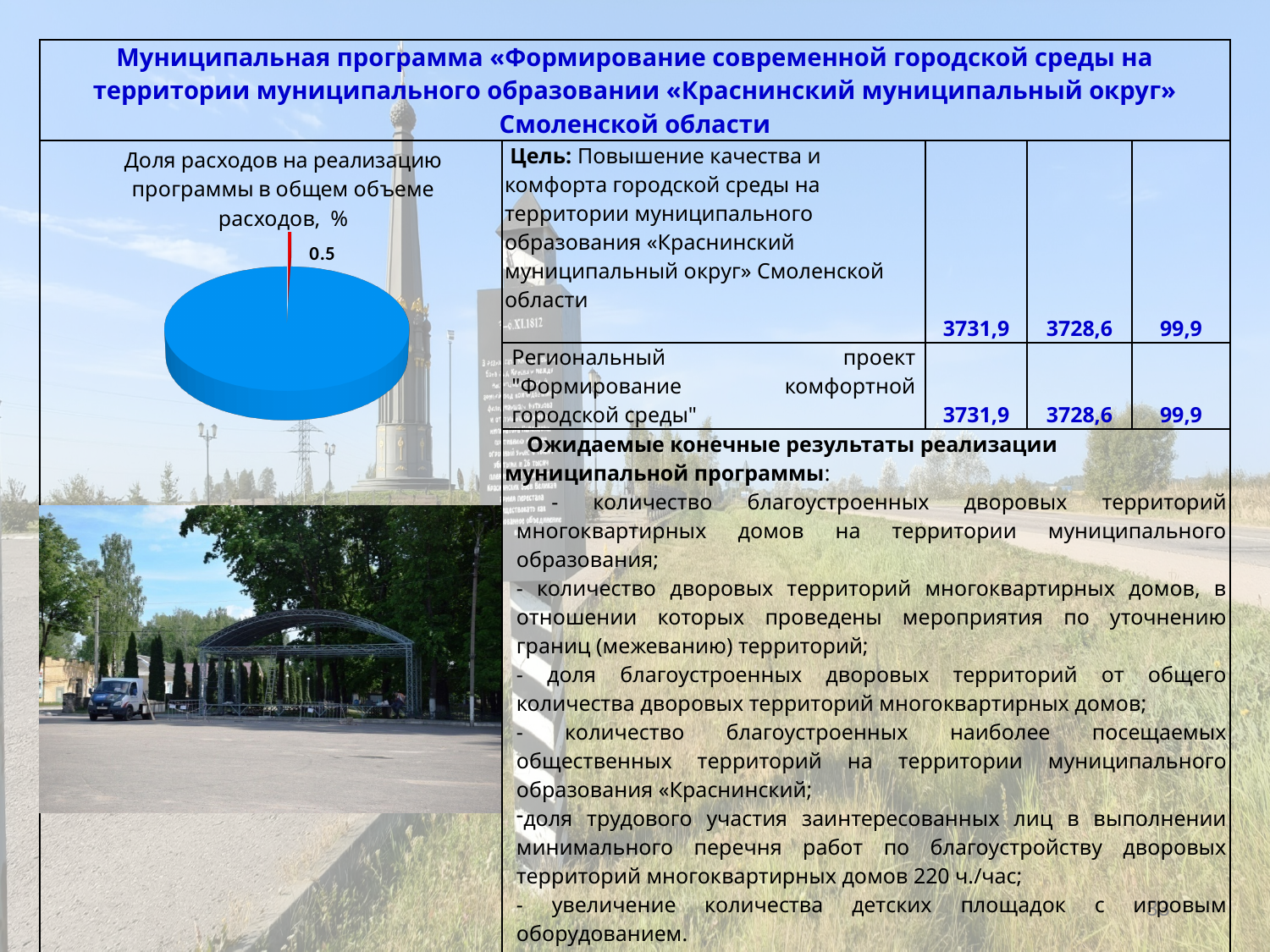
In the pie chart, which slice is larger: the blue slice or the red slice? the blue slice What kind of chart is shown on the left of the slide? pie chart What colour is the largest slice of the pie chart? blue Which slice of the pie chart is the smallest? the red slice Is the value labelled on the red slice of the pie chart greater or less than 1? less What value is printed as the data label on the pie chart? 0.5 How many slices does the pie chart have? 2 What is the title of the pie chart on the left of the slide? Доля расходов на реализацию программы в общем объеме расходов, %